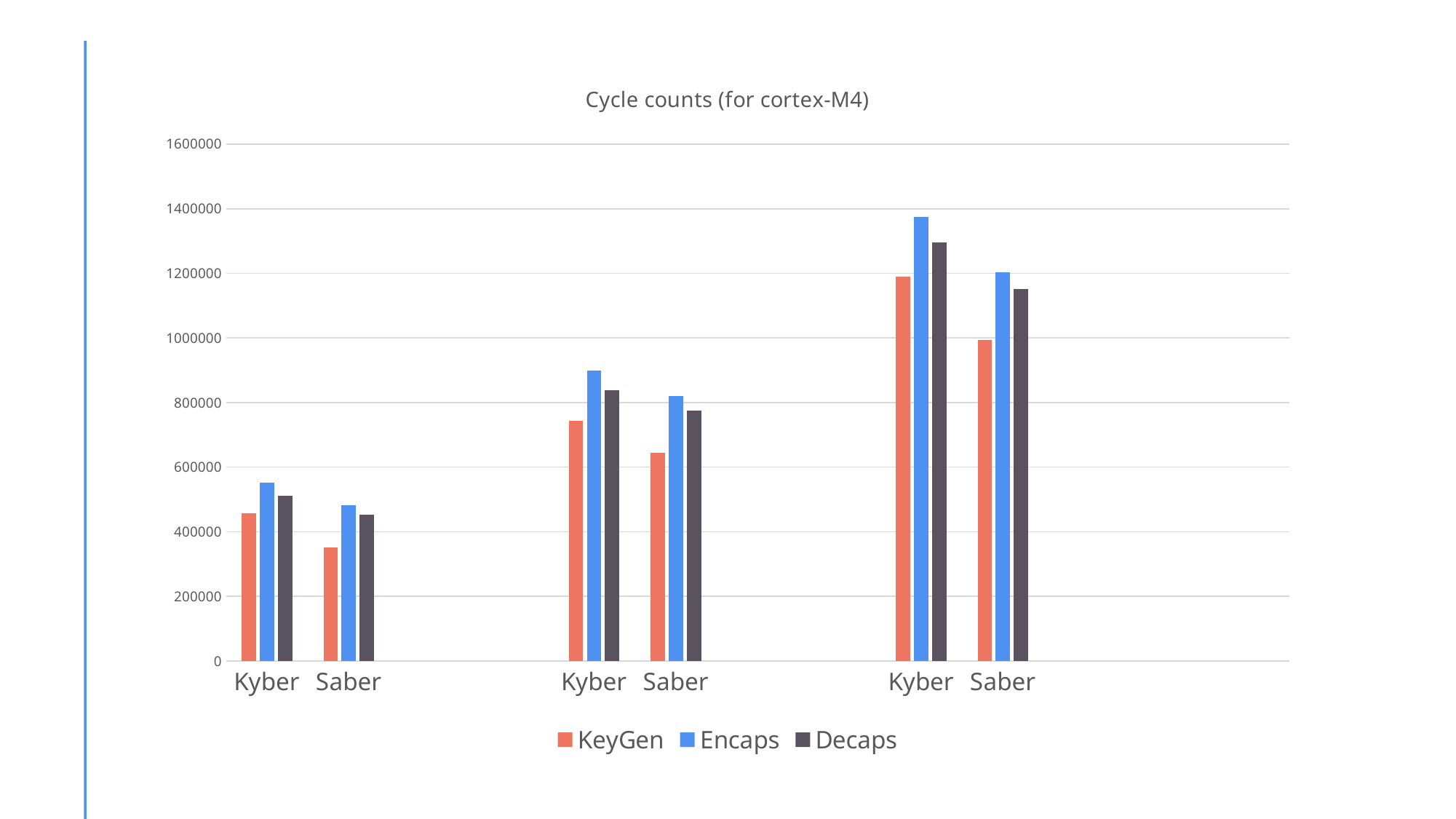
Do the cycle counts rise or fall moving from the leftmost group to the rightmost group? rise Which series is shown in blue in the legend? Encaps Is the Encaps value for the rightmost Kyber greater or less than 1200000? greater In the rightmost pair, which has the larger Encaps value, Kyber or Saber? Kyber Which bar is the shortest in the chart? KeyGen for the leftmost Saber What is the title of the chart? Cycle counts (for cortex-M4) What kind of chart is shown on the slide? Bar chart How many series does the legend list? 3 Which bar is the tallest in the chart? Encaps for the rightmost Kyber How many category labels are shown along the x axis? 6 Is the Encaps value for the middle Kyber greater or less than 1000000? less Is the KeyGen value for the leftmost Saber greater or less than 400000? less